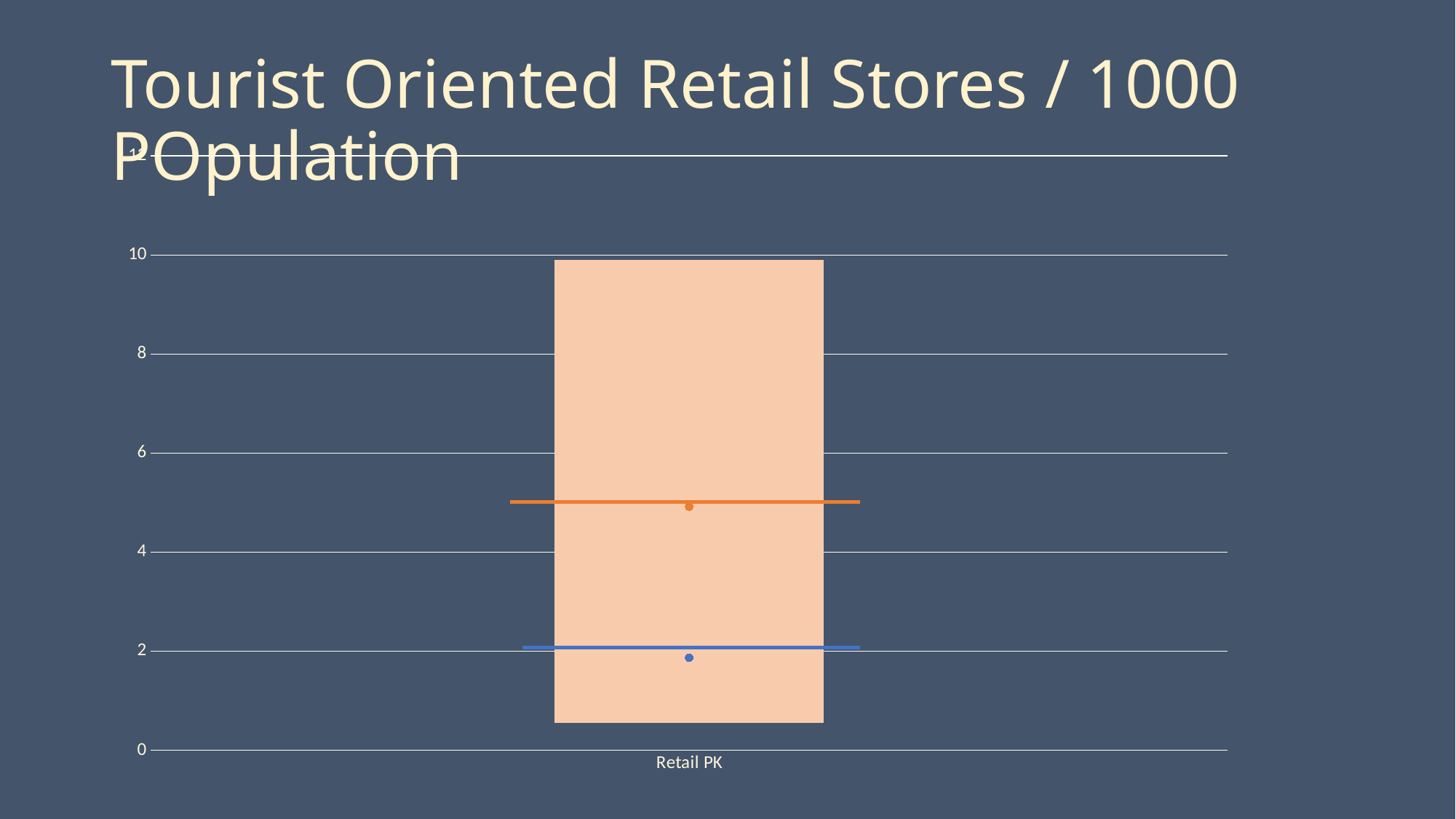
Which marker for Retail PK sits higher on the y axis, the orange one or the blue one? the orange one What is the label of the single category on the x axis? Retail PK Is the orange horizontal line for Retail PK greater or less than 6? less Is the orange marker for Retail PK greater or less than 4? greater Is the blue marker for Retail PK greater or less than 4? less What is the title of the chart on the slide? Tourist Oriented Retail Stores / 1000 POpulation How many categories are shown on the x axis of the chart? 1